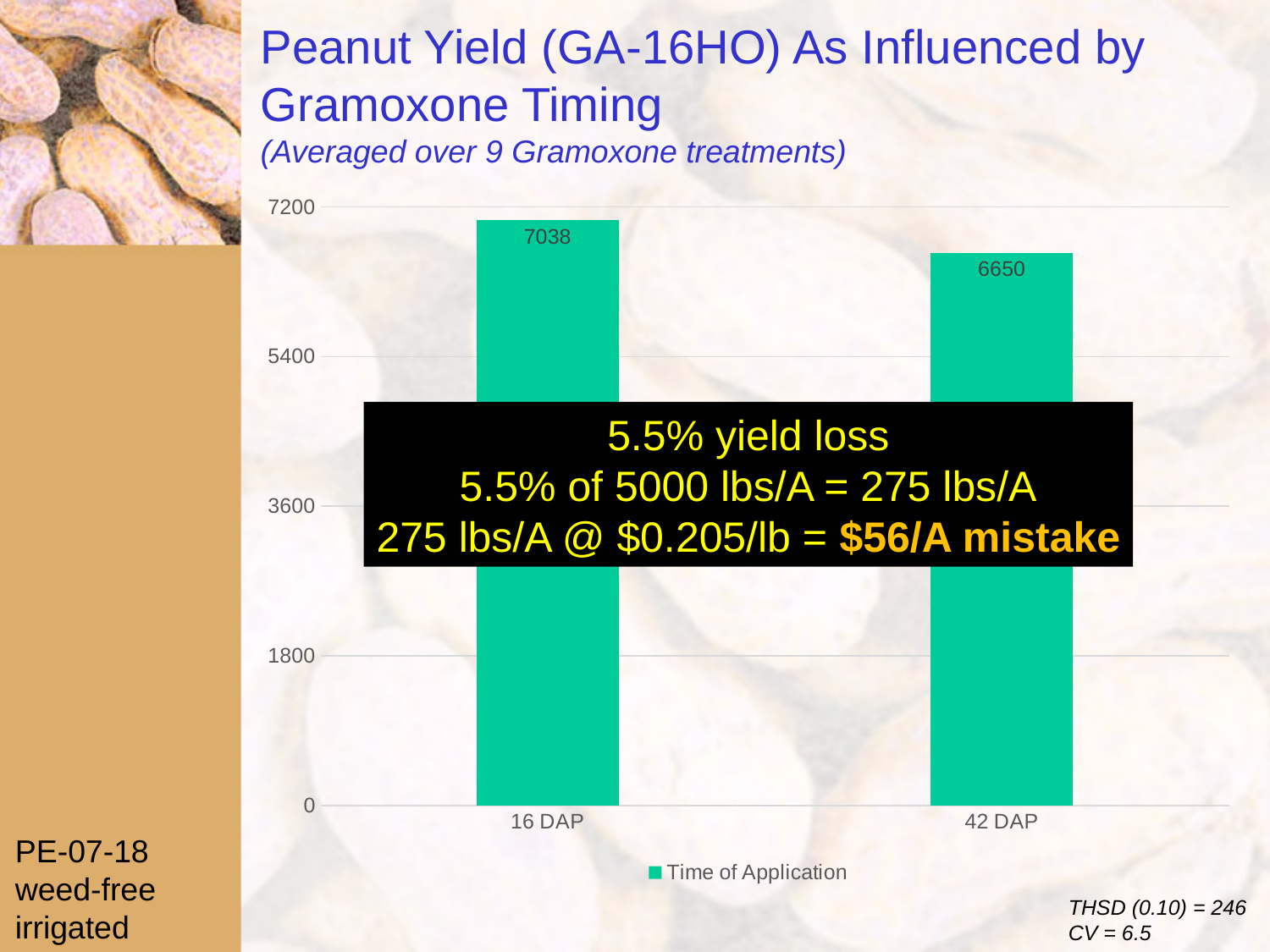
How many series does the legend list? 1 What is the legend entry for the series on the chart? Time of Application Which application timing has the lowest yield? 42 DAP How many application timings are shown on the chart? 2 What is the peanut yield for 42 DAP? 6650 Which has a larger yield, 16 DAP or 42 DAP? 16 DAP Is the yield for 42 DAP greater or less than 5400? greater What is the difference in yield between 16 DAP and 42 DAP? 388 What kind of chart is shown on the slide? bar chart Is the yield for 16 DAP greater or less than 7200? less Which application timing has the highest yield? 16 DAP What is the peanut yield for 16 DAP? 7038